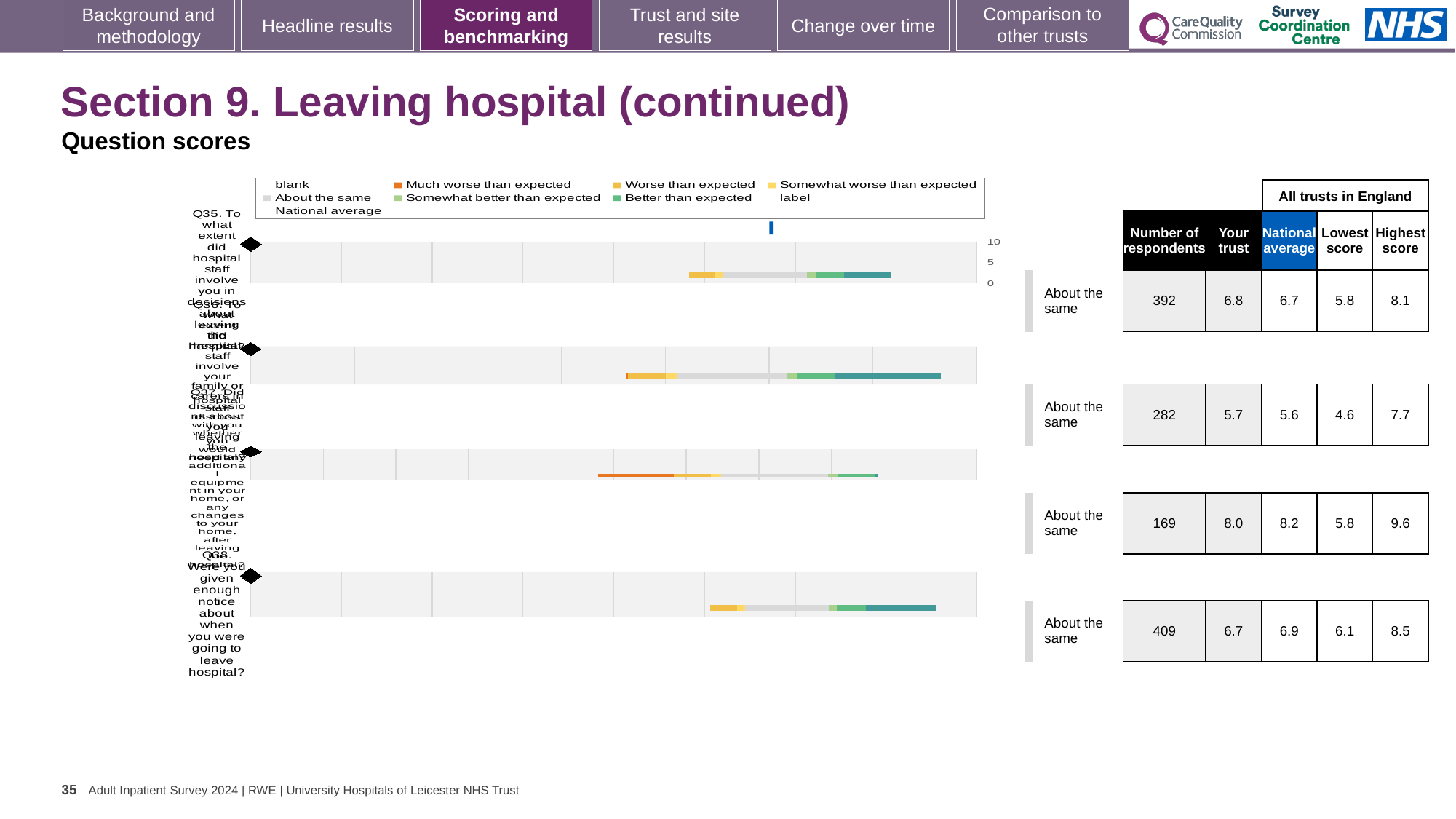
What benchmark category is shown next to the first chart (Q35)? About the same For the first chart (Q35), which is larger: the 'Your trust' score or the national average? Your trust For the last chart (Q38), which is larger: the 'Your trust' score or the national average? National average For the last chart (Q38, given enough notice about leaving hospital), what is the highest score among all trusts in England? 8.5 For the first chart (Q35), what is the 'Your trust' score? 6.8 For the first chart (Q35, involving you in decisions about leaving hospital), what is the number of respondents shown in the table? 392 For the last chart (Q38), what is the number of respondents? 409 What kind of chart is used to show the question scores on this slide? bar chart For the first chart (Q35), what is the national average score? 6.7 How many question charts are shown on the slide? 4 Which of the four charts has the highest 'Your trust' score? The third chart from the top (8.0) For the first chart (Q35), what is the difference between the highest score (8.1) and the lowest score (5.8)? 2.3